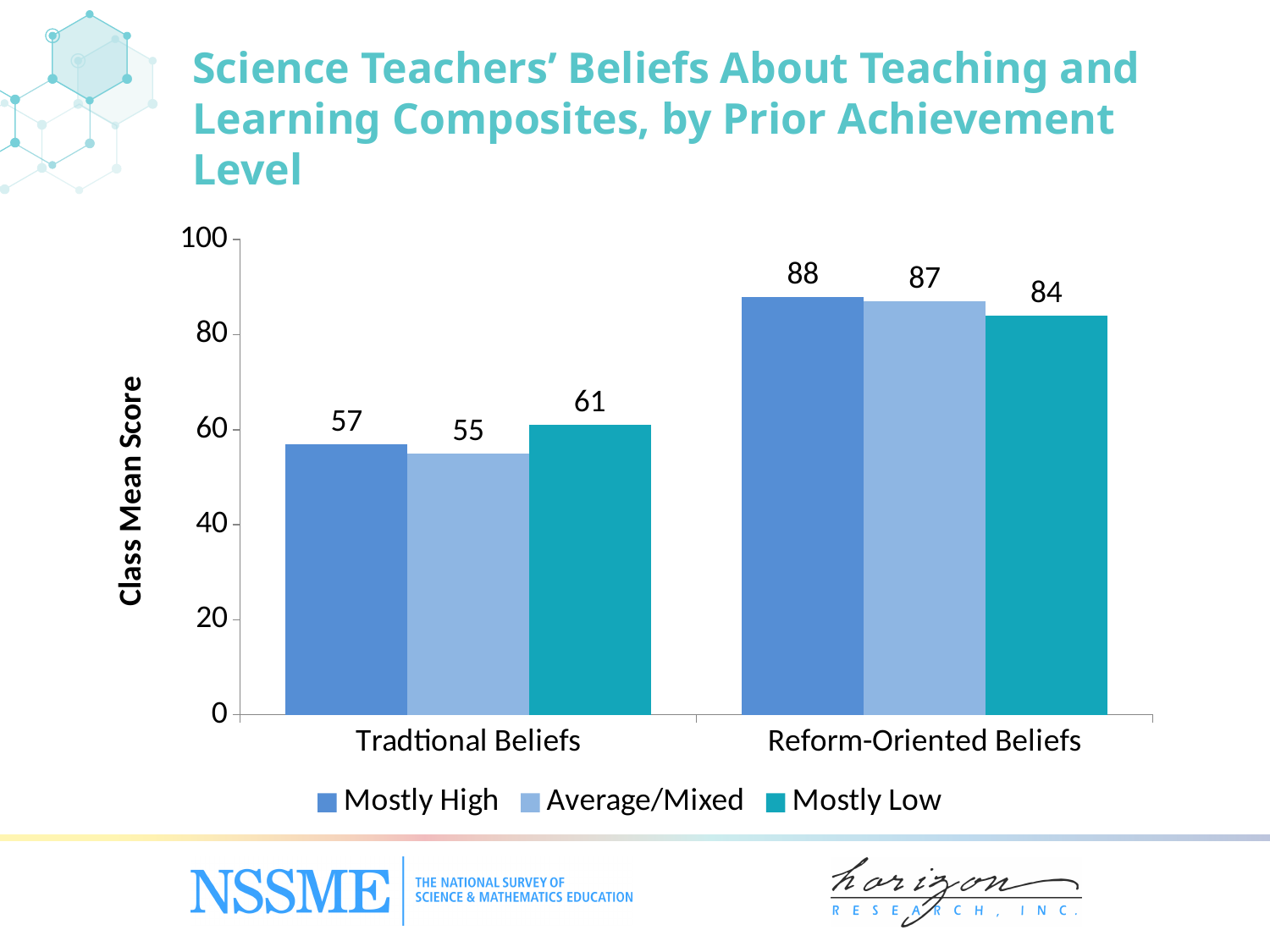
Which prior achievement level has the highest class mean score for Reform-Oriented Beliefs? Mostly High Which is larger: the Mostly High score for Traditional Beliefs or the Mostly High score for Reform-Oriented Beliefs? Reform-Oriented Beliefs What is the difference between the Mostly Low and Average/Mixed class mean scores for Traditional Beliefs? 6 What is the label on the vertical axis of the chart? Class Mean Score Which prior achievement level has the lowest class mean score for Traditional Beliefs? Average/Mixed Is the Mostly Low class mean score for Reform-Oriented Beliefs greater or less than 80? greater What is the class mean score for Mostly Low classes on Traditional Beliefs? 61 What is the difference between the Mostly High and Mostly Low class mean scores for Reform-Oriented Beliefs? 4 What kind of chart is shown on the slide? Bar chart What is the class mean score for Average/Mixed classes on Reform-Oriented Beliefs? 87 How many series does the legend list? 3 What is the class mean score for Mostly High classes on Traditional Beliefs? 57